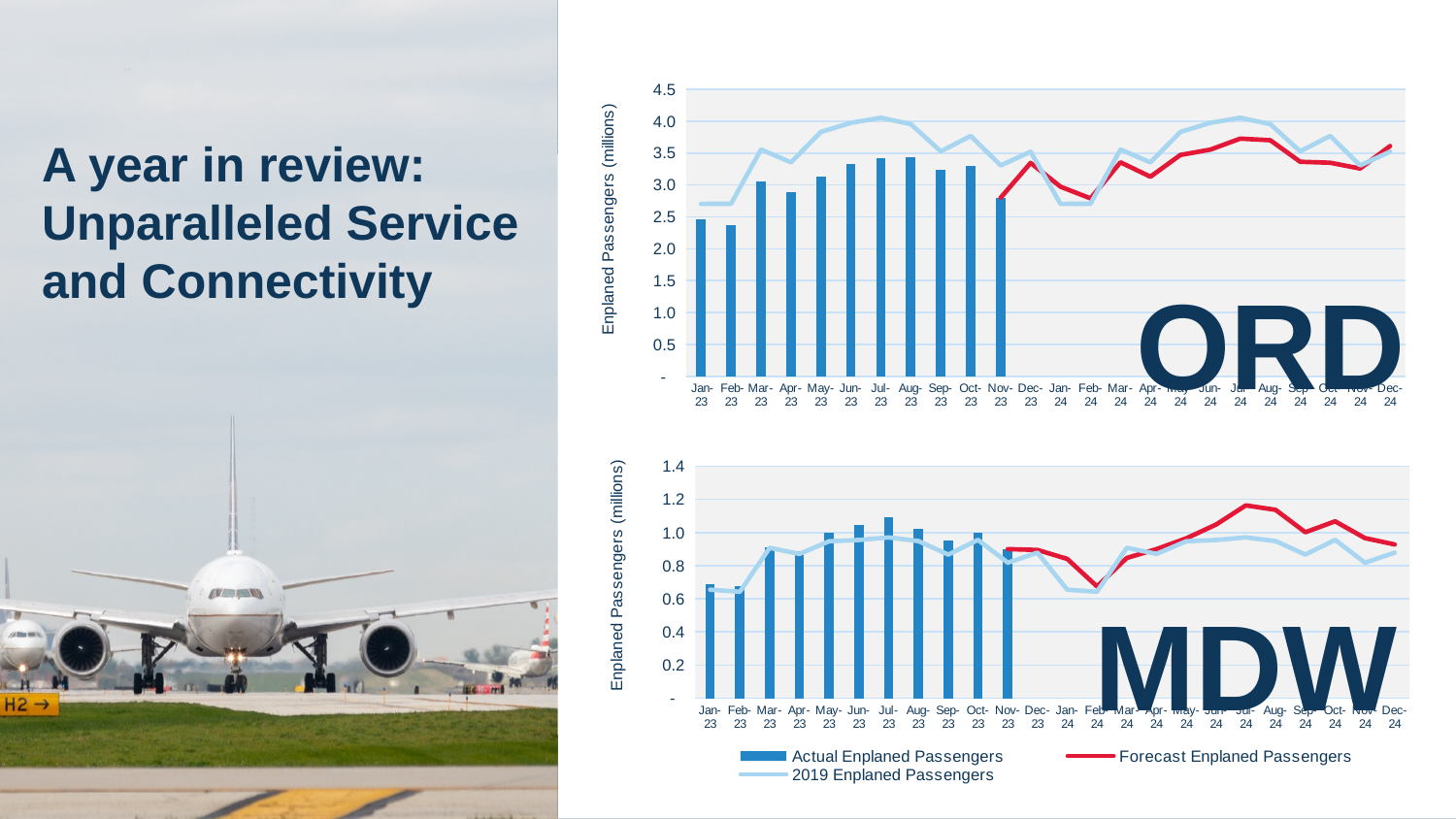
In the ORD chart, is the Actual Enplaned Passengers value for Jun-23 greater or less than 3.0? greater In the ORD chart, is the Actual Enplaned Passengers value for Feb-23 greater or less than 2.5? less In the ORD chart, which is larger: the Actual Enplaned Passengers bar for Jul-23 or for Feb-23? Jul-23 How many months are shown on the x axis of the ORD chart? 24 What kind of chart is the ORD chart at the top of the slide? A combined bar and line chart In the MDW chart, is the Actual Enplaned Passengers value for Feb-23 greater or less than 0.8? less In the MDW chart, does the Forecast Enplaned Passengers line rise or fall from Jul-24 to Nov-24? Fall What is the y-axis label on the MDW chart? Enplaned Passengers (millions) In the MDW chart, which month has the highest Actual Enplaned Passengers bar? Jul-23 How many series does the legend list for the charts? 3